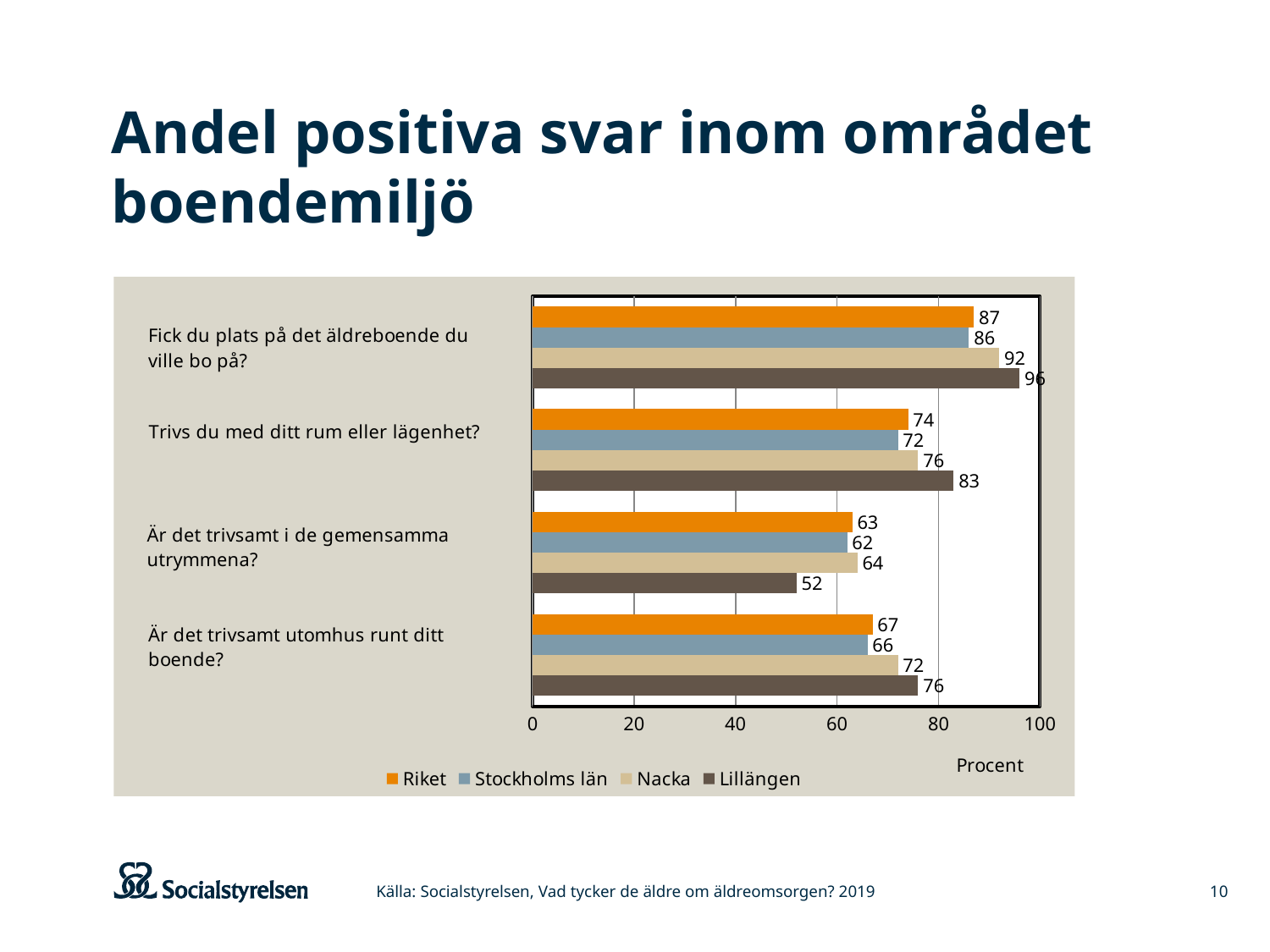
Which series has the lowest value on "Är det trivsamt i de gemensamma utrymmena?"? Lillängen How many question categories are shown on the chart? 4 What is the label on the horizontal axis of the chart? Procent How many series does the legend list? 4 What is the difference between Lillängen and Riket on "Trivs du med ditt rum eller lägenhet?"? 9 What kind of chart is shown on the slide? Bar chart Which series has the highest value on "Trivs du med ditt rum eller lägenhet?"? Lillängen What is the value for Lillängen on "Fick du plats på det äldreboende du ville bo på?"? 96 Which is larger on "Är det trivsamt utomhus runt ditt boende?": Riket or Lillängen? Lillängen What is the value for Riket on "Trivs du med ditt rum eller lägenhet?"? 74 What is the value for Nacka on "Är det trivsamt utomhus runt ditt boende?"? 72 What is the value for Stockholms län on "Är det trivsamt i de gemensamma utrymmena?"? 62